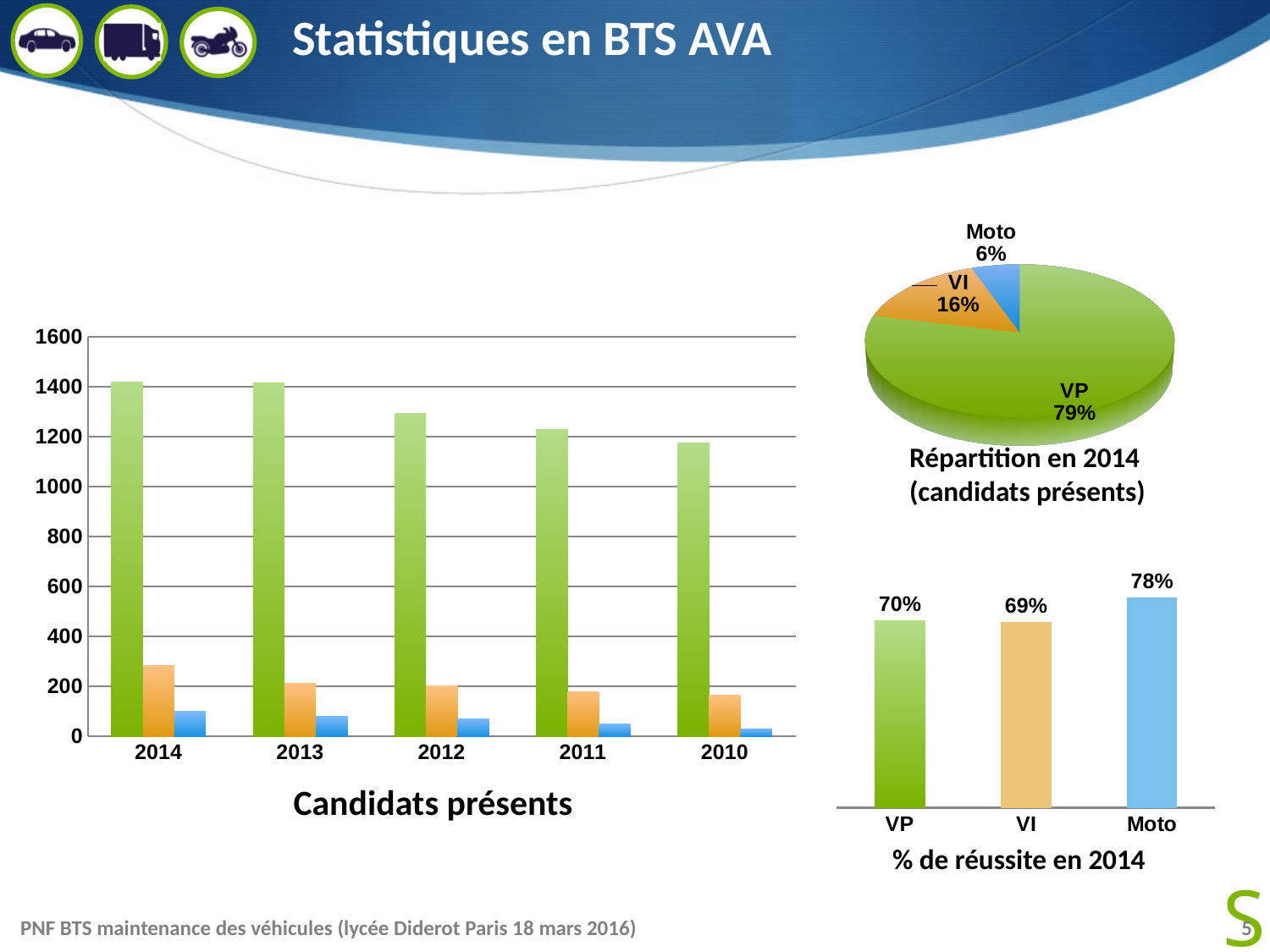
In the '% de réussite en 2014' chart, what is the value for VP? 70% In the '% de réussite en 2014' chart, which category has the lowest value? VI In the 'Répartition en 2014 (candidats présents)' pie chart, how many slices are there? 3 In the 'Répartition en 2014 (candidats présents)' pie chart, what share does VP have? 79% In the 'Répartition en 2014 (candidats présents)' pie chart, which category has the smallest slice? Moto In the '% de réussite en 2014' chart, which category has the highest value? Moto In the 'Candidats présents' chart, how many years are shown on the x axis? 5 In the '% de réussite en 2014' chart, what is the difference between the values for Moto and VI? 9% In the 'Candidats présents' chart, is the green bar for 2010 greater or less than 1000? greater In the '% de réussite en 2014' chart, what is the value for Moto? 78% What kind of chart is 'Candidats présents'? bar chart In the 'Candidats présents' chart, is the orange bar for 2014 greater or less than 200? greater